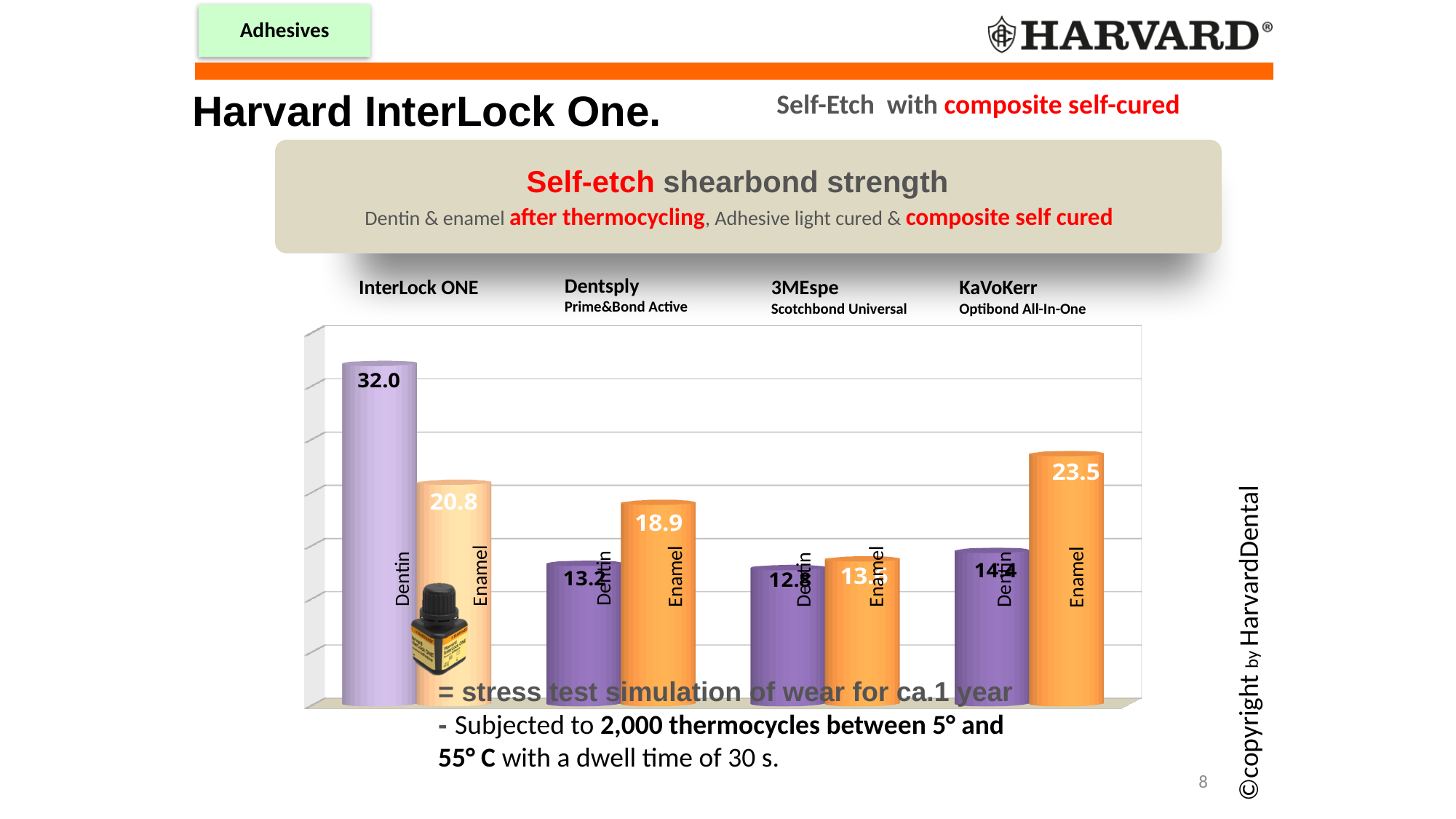
Which product has the highest Dentin bar? InterLock ONE Which product has the lowest Enamel bar? 3MEspe Scotchbond Universal How many adhesive products are compared in the chart? 4 What is the Dentin shear bond strength value shown for InterLock ONE? 32.0 What is the Enamel value shown for Dentsply Prime&Bond Active? 18.9 What kind of chart is shown on the slide? Bar chart What is the difference between the Dentin and Enamel values for InterLock ONE? 11.2 What is the Dentin value shown for Dentsply Prime&Bond Active? 13.2 Which is larger: the Enamel value for InterLock ONE or the Enamel value for KaVoKerr Optibond All-In-One? KaVoKerr Optibond All-In-One Which product has the highest Enamel bar? KaVoKerr Optibond All-In-One What is the Enamel value shown for InterLock ONE? 20.8 What is the Enamel value shown for KaVoKerr Optibond All-In-One? 23.5